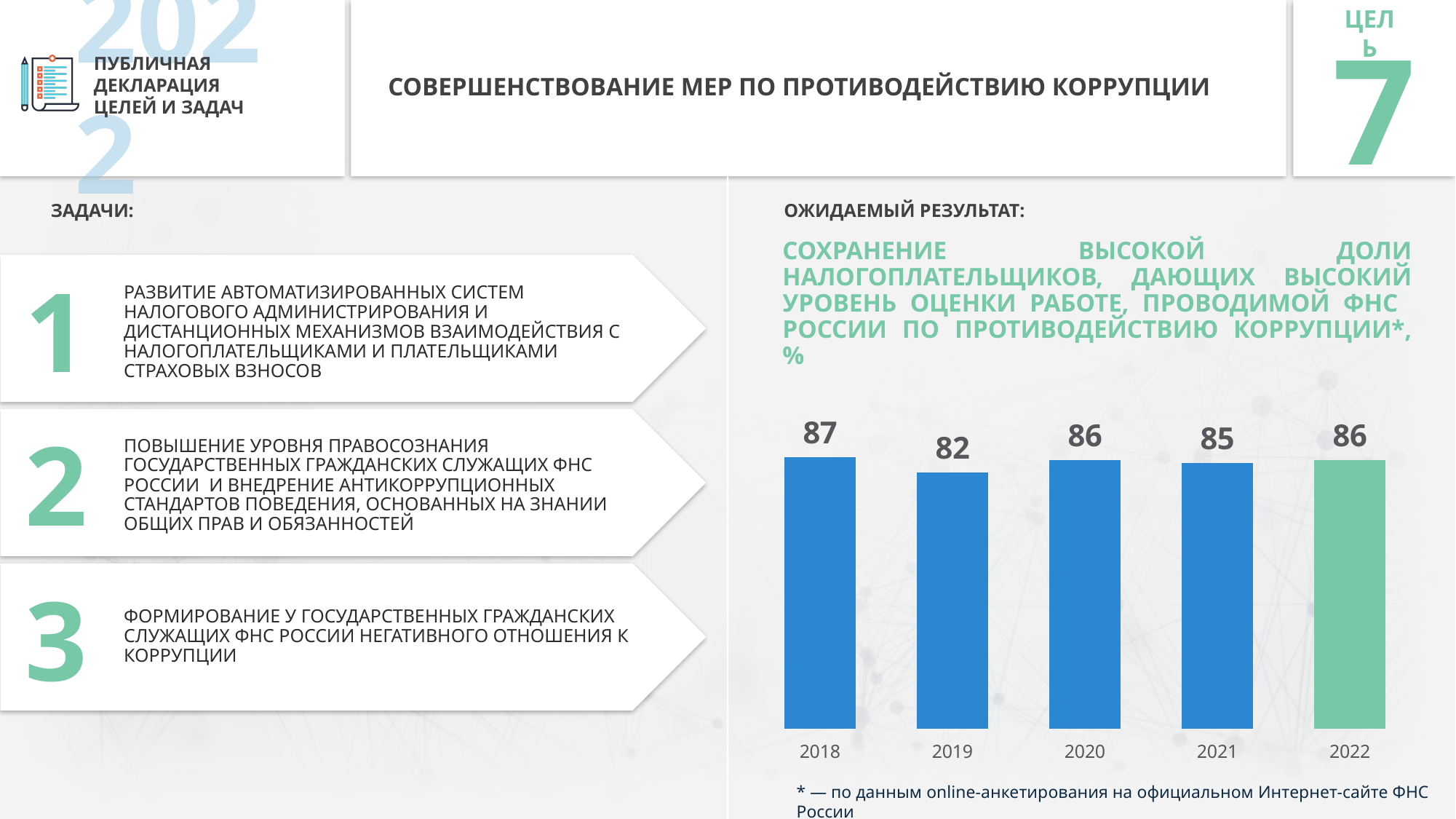
What is the difference between the values for 2018 and 2019? 5 Do the values rise or fall from 2019 to 2020? rise Which is larger, the value for 2020 or the value for 2021? 2020 What is the value for 2019? 82 Which bar is coloured green rather than blue? 2022 Which year has the lowest value? 2019 Which year has the highest value? 2018 What is the value for 2018? 87 How many years are shown on the chart? 5 What kind of chart is shown on the slide? bar chart What is the value for 2022? 86 What is the value for 2021? 85